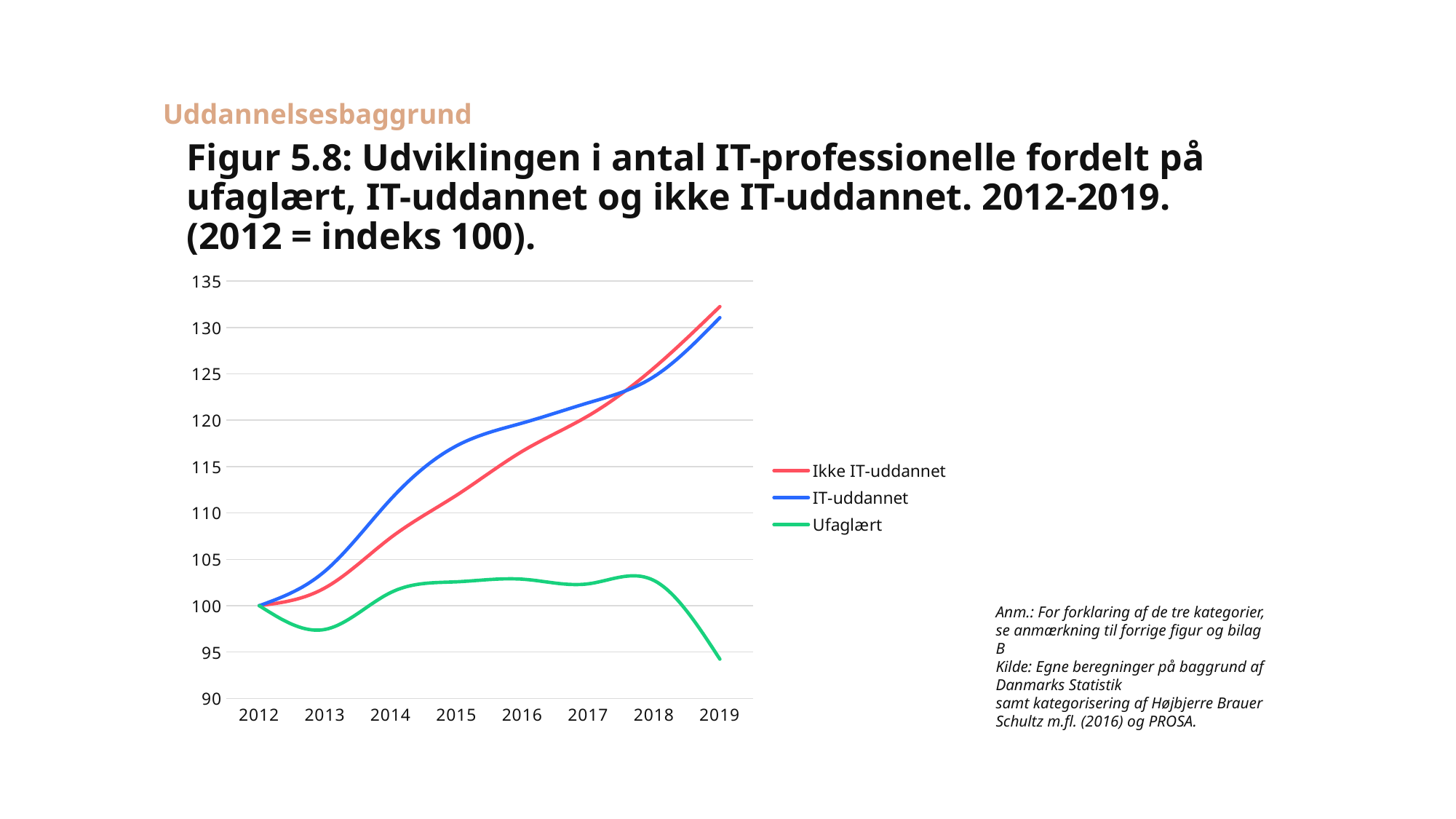
Which series has the lowest value in 2019? Ufaglært How many series does the legend list? 3 What is the index value for all three series in 2012? 100 Is the value for IT-uddannet in 2015 greater or less than 115? greater Is the value for Ufaglært in 2013 greater or less than 100? less In 2015, which is larger: IT-uddannet or Ikke IT-uddannet? IT-uddannet Is the value for Ufaglært in 2019 greater or less than 100? less What kind of chart is shown on the slide? line chart How many years are shown on the x axis? 8 Which series has the highest value in 2016? IT-uddannet Does the Ikke IT-uddannet line rise or fall from 2012 to 2019? rise